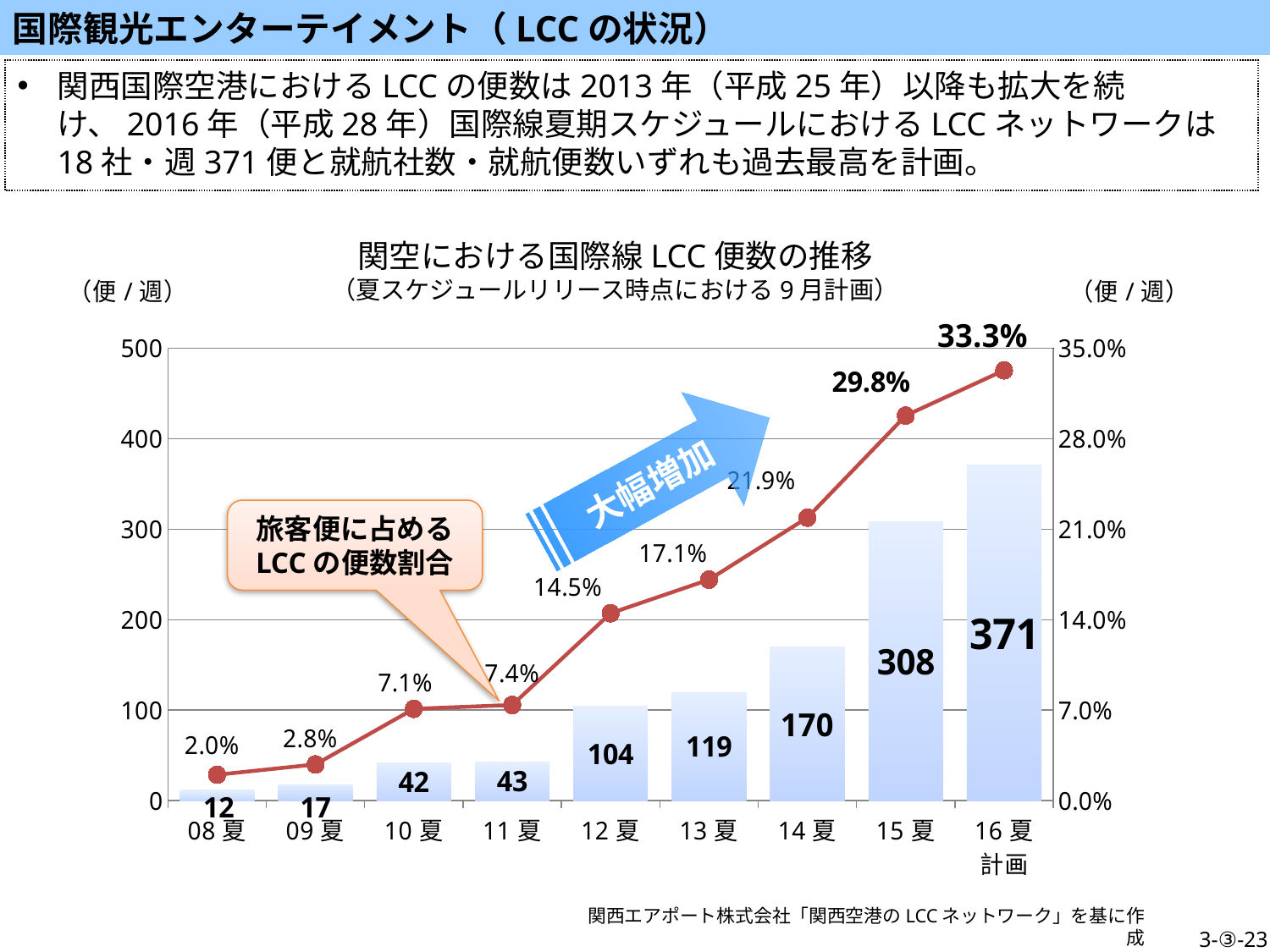
What is the number of LCC flights per week for 14夏? 170 What is the title of the chart? 関空における国際線LCC便数の推移 Which period has the highest number of LCC flights per week? 16夏計画 Do the LCC flight numbers rise or fall from 08夏 to 16夏計画? Rise What is the LCC share of passenger flights (line) for 12夏? 14.5% What kind of chart is this? Combined bar and line chart What is the number of LCC flights per week for 16夏計画? 371 Which period has the lowest number of LCC flights per week? 08夏 What is the difference in LCC flights per week between 15夏 and 14夏? 138 How many periods are shown on the x axis? 9 Which has more LCC flights per week, 12夏 or 13夏? 13夏 What is the LCC share of passenger flights (line) for 15夏? 29.8%